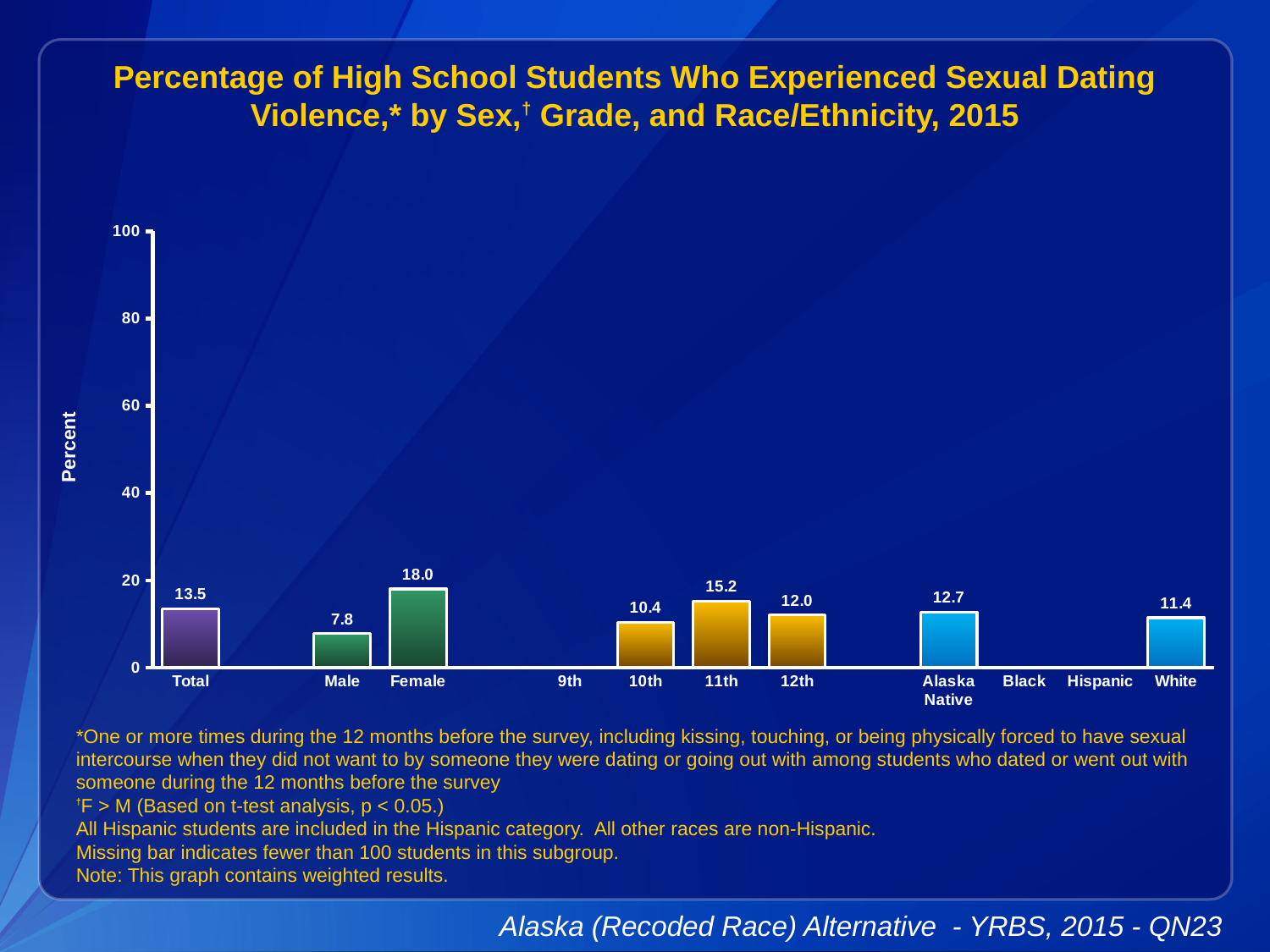
What kind of chart is this? bar chart Which category has the highest value? Female What is the value for Female? 18.0 How many categories have a bar shown? 8 What is the value for Alaska Native? 12.7 What is the value for Total? 13.5 Which category with a bar has the lowest value? Male Is the value for White greater or less than 20? less Which is larger, the value for 10th grade or 12th grade? 12th What is the value for 11th grade? 15.2 What is the difference between the Female and Male values? 10.2 What is the label on the y axis? Percent